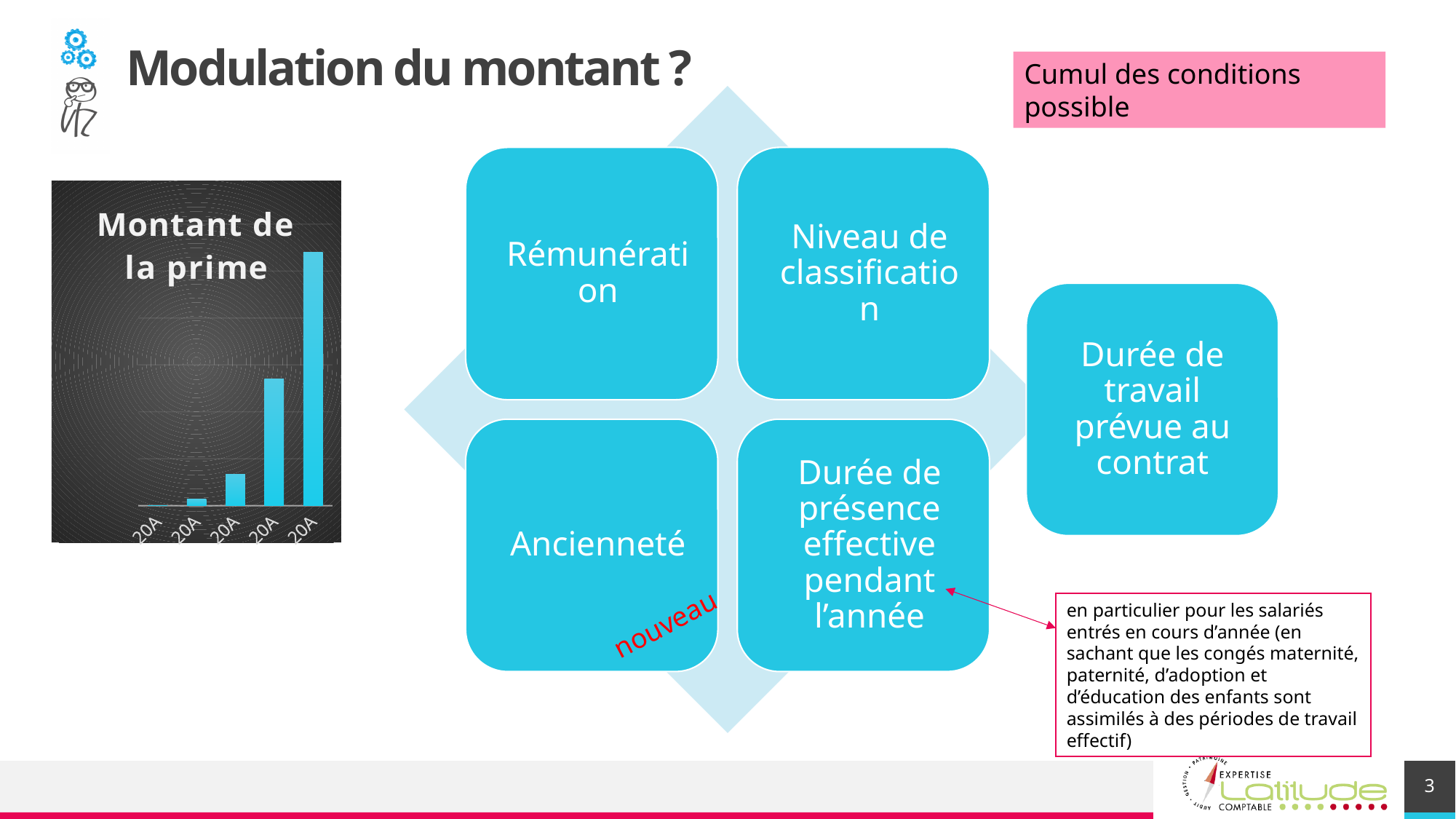
In the "Montant de la prime" chart, is the fourth bar from the left taller or shorter than the third bar? taller What colour are the bars in the "Montant de la prime" chart? light blue In the "Montant de la prime" chart, do the bar values rise or fall from left to right? rise How many bars are plotted in the "Montant de la prime" chart? 5 What is the title of the bar chart on the slide? Montant de la prime What kind of chart is the "Montant de la prime" chart? bar chart Which bar is the shortest in the "Montant de la prime" chart, the leftmost or the rightmost? the leftmost Which bar is the tallest in the "Montant de la prime" chart, the leftmost or the rightmost? the rightmost